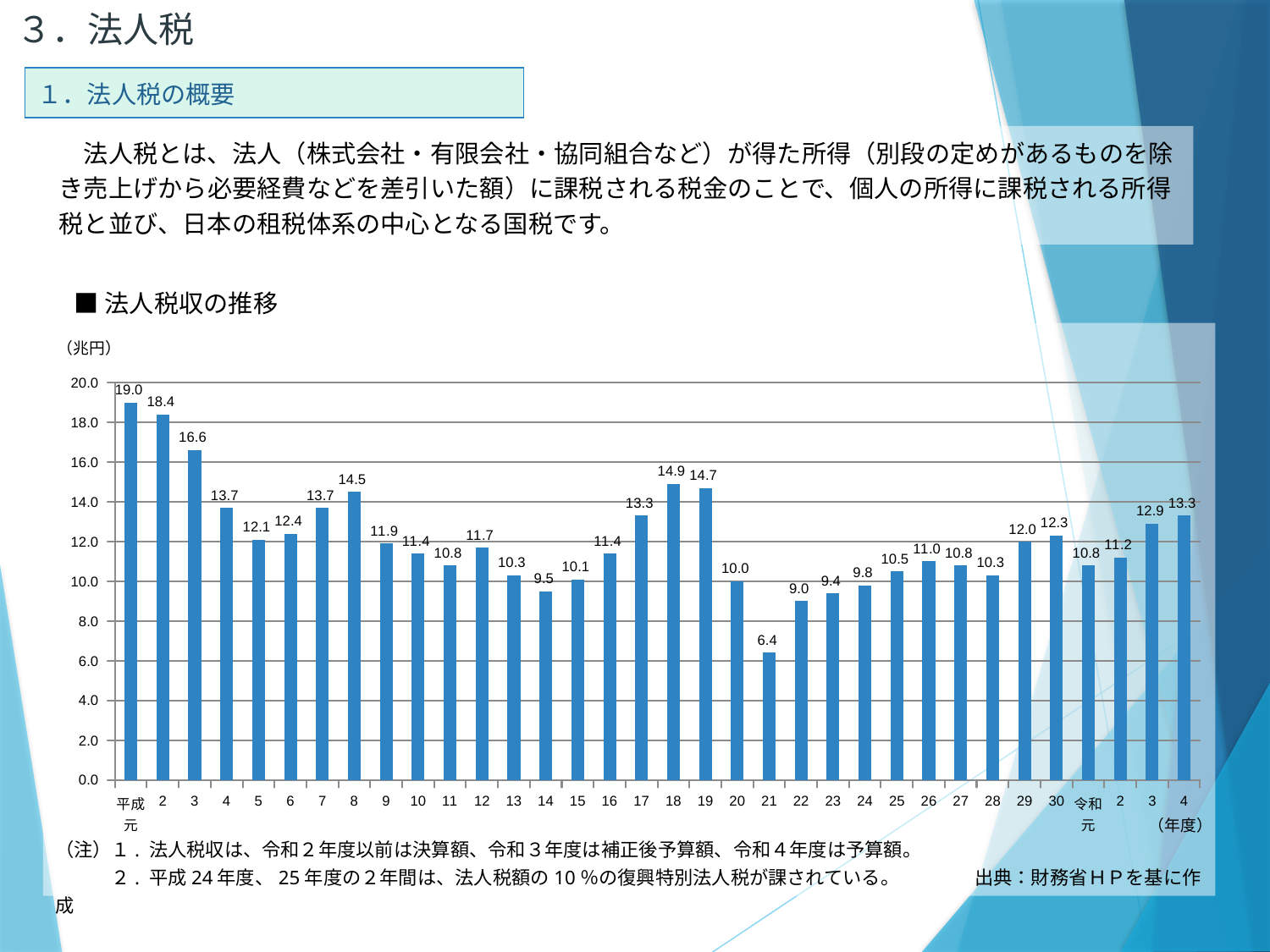
「法人税収の推移」のグラフで、平成元年度から平成5年度にかけて値は上昇していますか、下降していますか。 下降 「法人税収の推移」のグラフで、法人税収が最も低い年度はどれですか。 平成21 「法人税収の推移」のグラフで、平成18年度と平成20年度の値の差はいくらですか。 4.9 「法人税収の推移」のグラフの縦軸の単位は何ですか。 兆円 「法人税収の推移」のグラフで、平成3年度の値は16.0より大きいですか、小さいですか。 大きい 「法人税収の推移」のグラフで、平成21年度の値はいくらですか。 6.4 「法人税収の推移」のグラフで、法人税収が最も高い年度はどれですか。 平成元 「法人税収の推移」のグラフで、平成元年度の法人税収はいくらですか。 19.0 「法人税収の推移」のグラフで、平成30年度と令和元年度では、どちらの値が大きいですか。 平成30 「法人税収の推移」のグラフで、令和4年度の値はいくらですか。 13.3 「法人税収の推移」のグラフはどの種類のグラフですか。 棒グラフ 「法人税収の推移」のグラフには、いくつの年度の棒が表示されていますか。 34